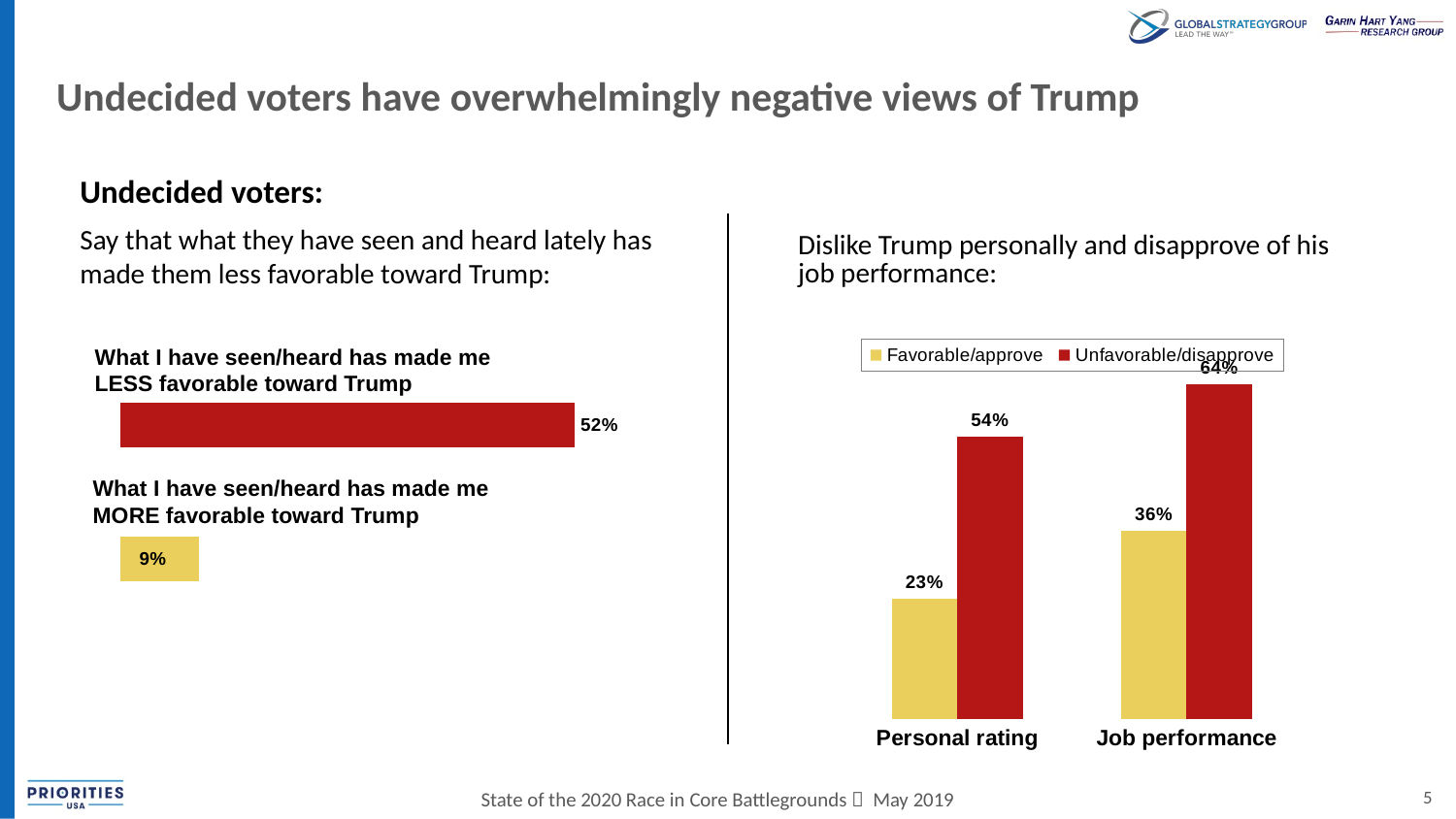
In the right chart, what is the Favorable/approve value for Job performance? 36% In the right chart, what is the Unfavorable/disapprove value for Job performance? 64% In the right chart, which bar is the highest? Unfavorable/disapprove for Job performance (64%) In the right chart, what is the difference between Unfavorable/disapprove and Favorable/approve for Personal rating? 31 percentage points In the left chart, which response has the larger value: LESS favorable or MORE favorable? LESS favorable toward Trump In the right chart, what is the Favorable/approve value for Personal rating? 23% What kind of chart is the left chart? Bar chart How many series does the legend of the right chart list? 2 In the left chart, what is the difference between the LESS favorable and MORE favorable percentages? 43 percentage points In the left chart, what percentage of undecided voters say what they have seen/heard has made them LESS favorable toward Trump? 52% In the right chart, what colour represents Unfavorable/disapprove? Red In the left chart, what percentage say what they have seen/heard has made them MORE favorable toward Trump? 9%